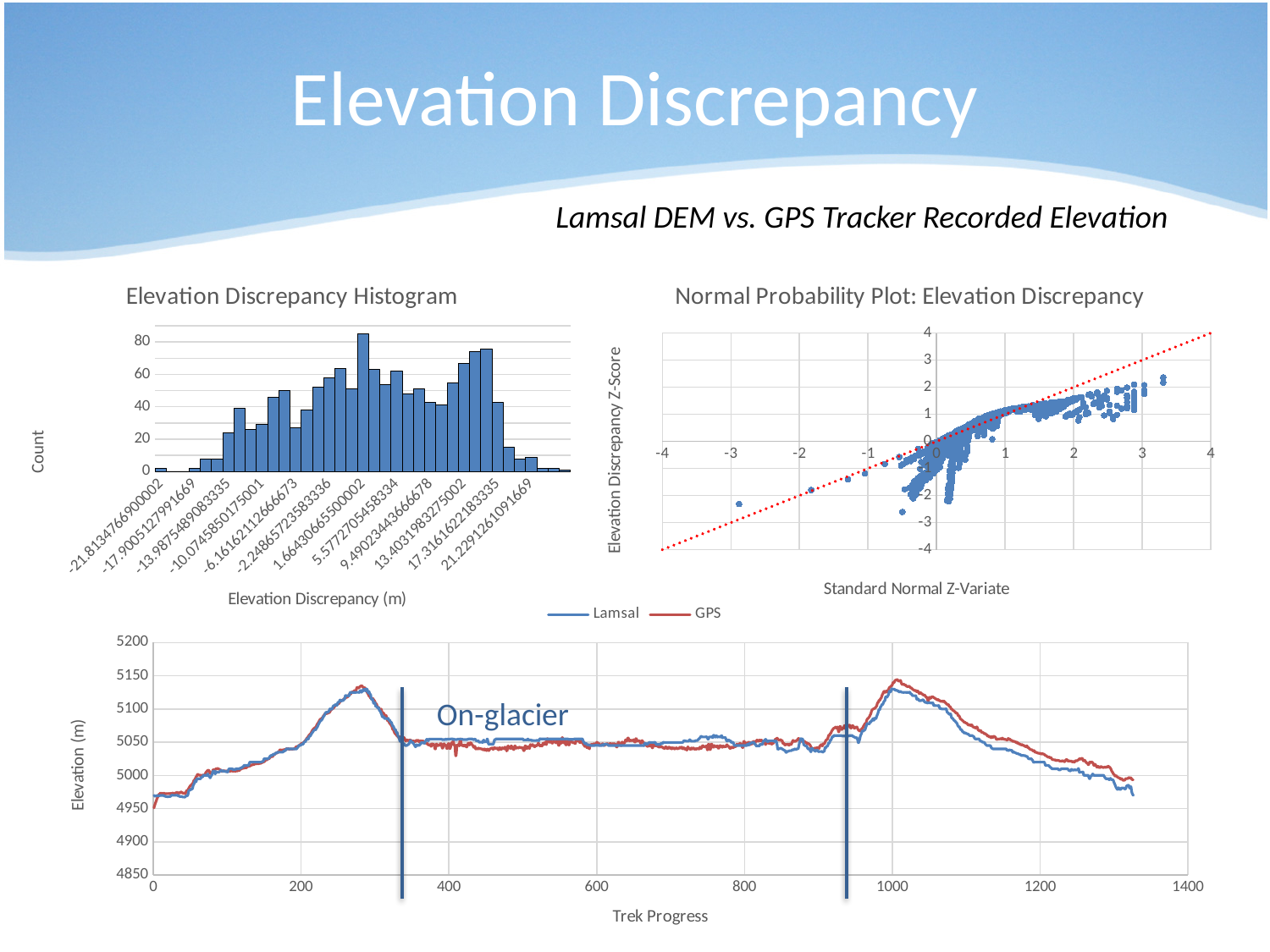
In the bottom elevation chart, is the peak elevation reached near Trek Progress 300 greater or less than 5100? greater What is the y-axis label of the Normal Probability Plot: Elevation Discrepancy? Elevation Discrepancy Z-Score What kind of chart is the Normal Probability Plot: Elevation Discrepancy? scatter plot What are the two series named in the legend of the bottom elevation chart? Lamsal and GPS In the Elevation Discrepancy Histogram, is the count for the bin labelled -21.8134766900002 greater or less than 20? less In the bottom elevation chart, is the Lamsal elevation at Trek Progress 0 greater or less than 5000? less What kind of chart is the Elevation Discrepancy Histogram? bar chart What kind of chart is the bottom chart showing Elevation (m) against Trek Progress? line chart How many series does the legend of the bottom elevation chart list? 2 In the bottom elevation chart, do the elevation values rise or fall between Trek Progress 1000 and 1300? fall